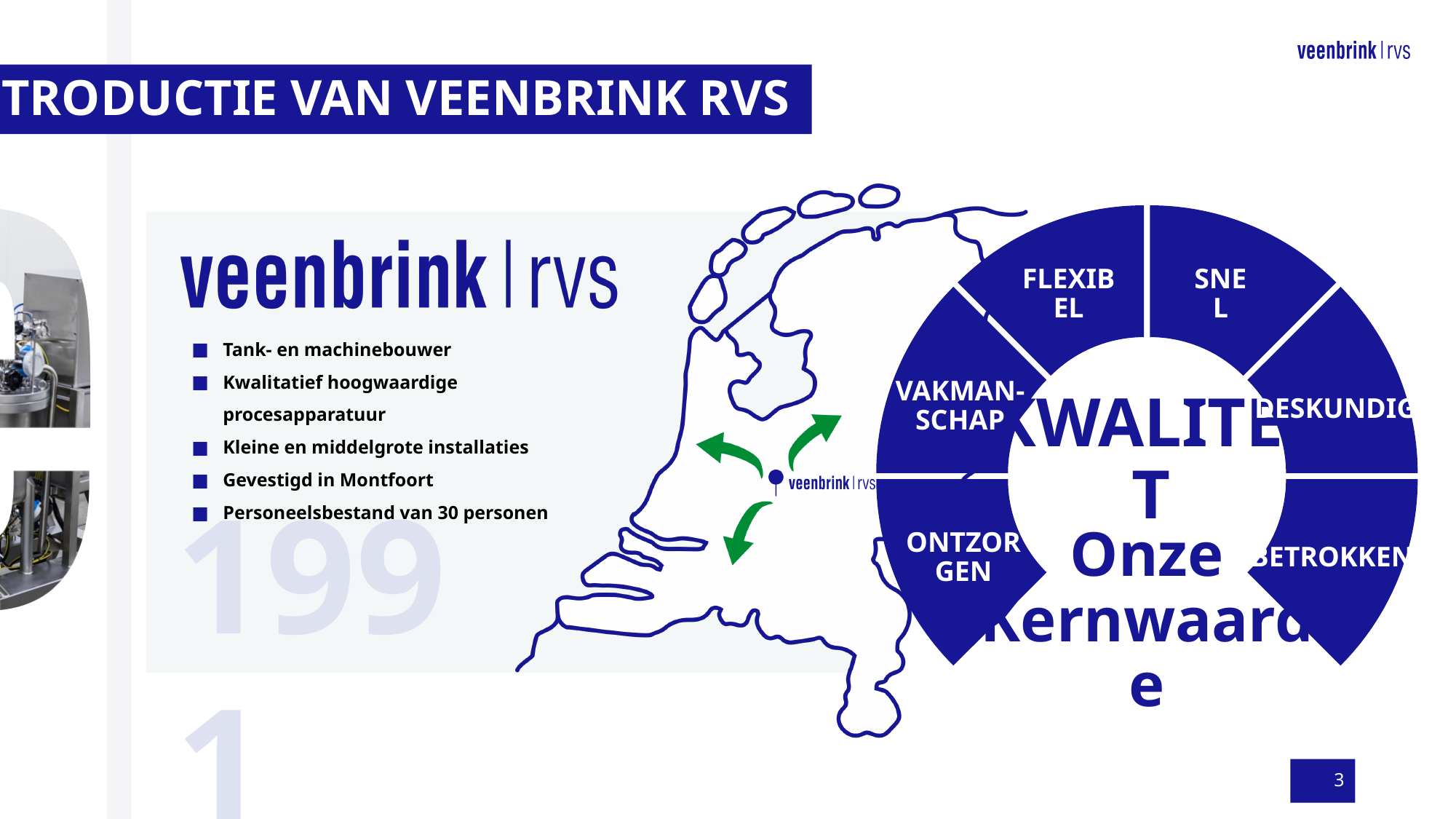
Which segment of the ring chart sits at the top left, next to SNEL? FLEXIBEL How many segments does the ring chart on the right of the slide have? 6 Which segment of the ring chart is labelled on the left, between FLEXIBEL and ONTZORGEN? VAKMANSCHAP Which segment of the ring chart is labelled on the right, between SNEL and BETROKKEN? DESKUNDIG Which segment of the ring chart is labelled at the bottom left? ONTZORGEN What text is shown in the centre of the ring chart? KWALITEIT Onze Kernwaarde What colour are the segments of the ring chart? dark blue What kind of chart is used for the core values on the right of the slide? doughnut chart Which segment of the ring chart is labelled at the bottom right? BETROKKEN